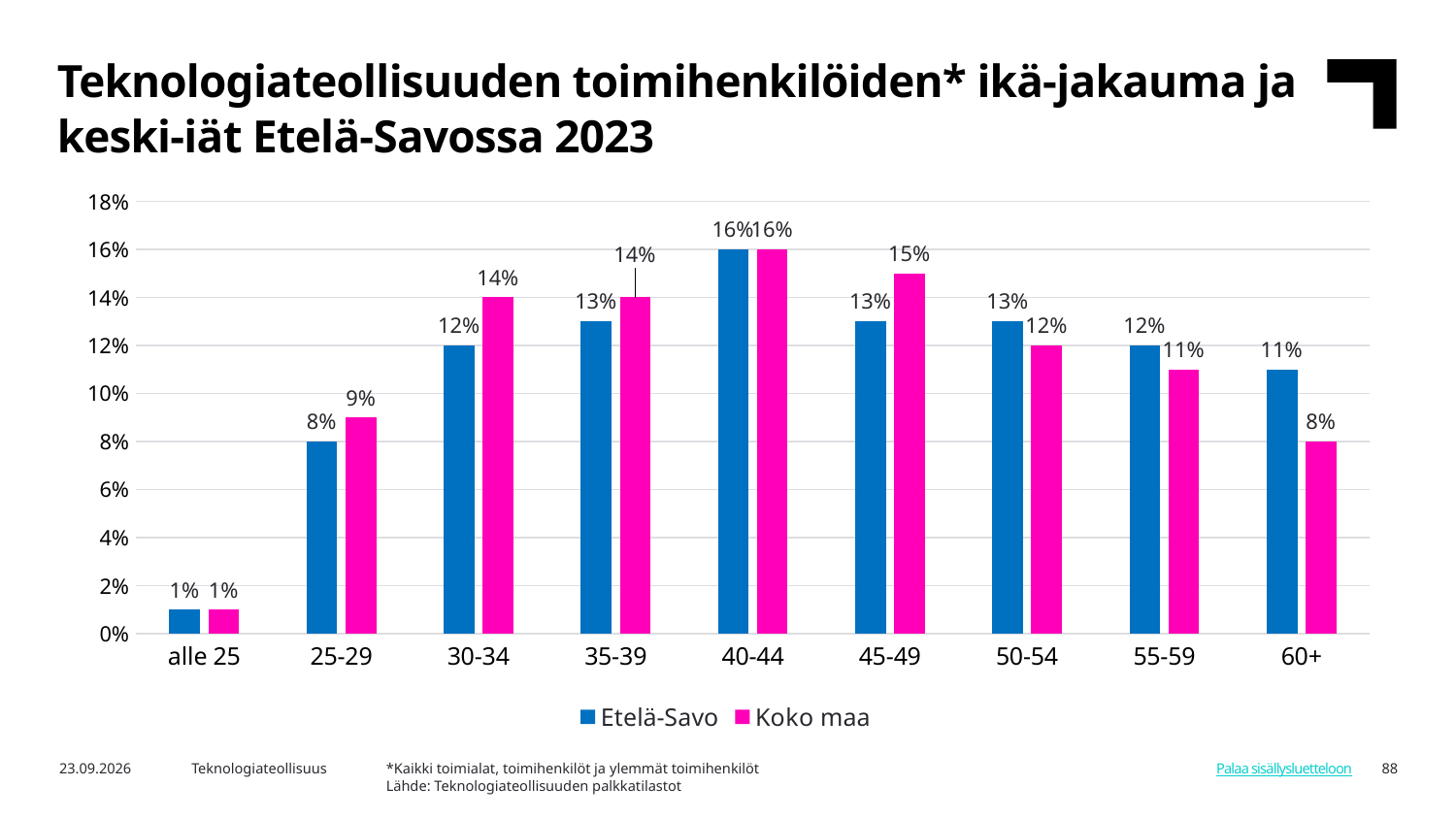
What kind of chart is shown on the slide? Bar chart Which series is shown in pink in the legend? Koko maa For the 45-49 age group, which series has the larger value, Etelä-Savo or Koko maa? Koko maa For the 50-54 age group, which series has the larger value, Etelä-Savo or Koko maa? Etelä-Savo What is the Koko maa value for the 45-49 age group? 15% Which age group has the highest Etelä-Savo value? 40-44 What is the difference between the Koko maa and Etelä-Savo values for the 60+ age group? 3% How many age groups are shown on the x axis? 9 Which age group has the lowest Koko maa value? alle 25 How many series does the legend list? 2 What is the Etelä-Savo value for the 30-34 age group? 12% What is the Koko maa value for the 60+ age group? 8%